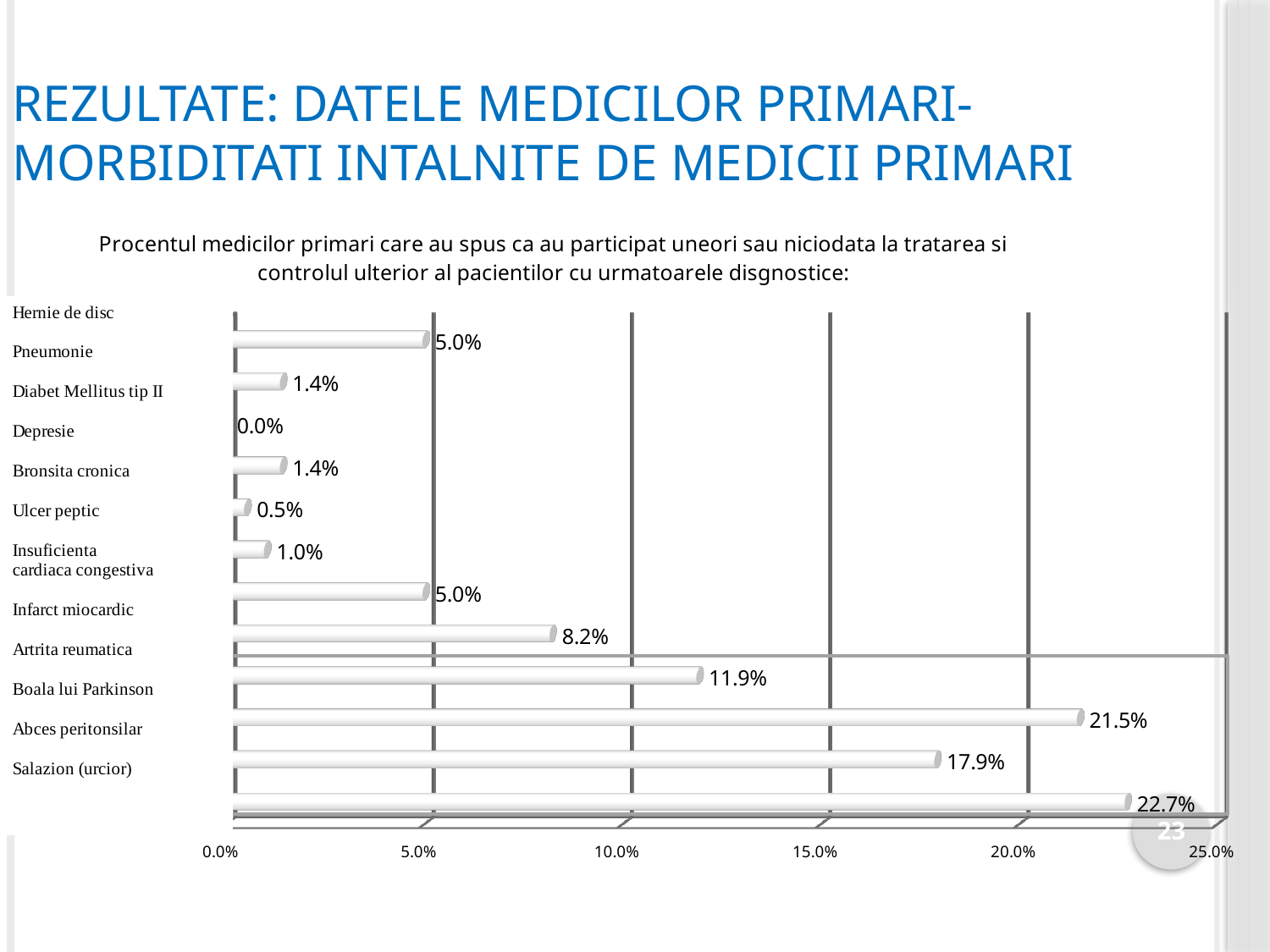
What is the highest value shown on the chart? 22.7% What is the value of the bottom-most bar on the chart? 22.7% What kind of chart is shown on the slide? bar chart What is the value of the top-most bar on the chart? 5.0% Is the value of the longest bar greater or less than 20.0%? greater How many bars on the chart have a value above 10.0%? 4 Which is larger, the bar labelled 17.9% or the bar labelled 21.5%? 21.5% How many categories (diagnoses) are listed on the chart? 12 What is the maximum value shown on the horizontal axis? 25.0% What is the difference between the two largest values on the chart, 22.7% and 21.5%? 1.2% What is the title of the chart? Procentul medicilor primari care au spus ca au participat uneori sau niciodata la tratarea si controlul ulterior al pacientilor cu urmatoarele disgnostice: What is the lowest value shown on the chart? 0.0%